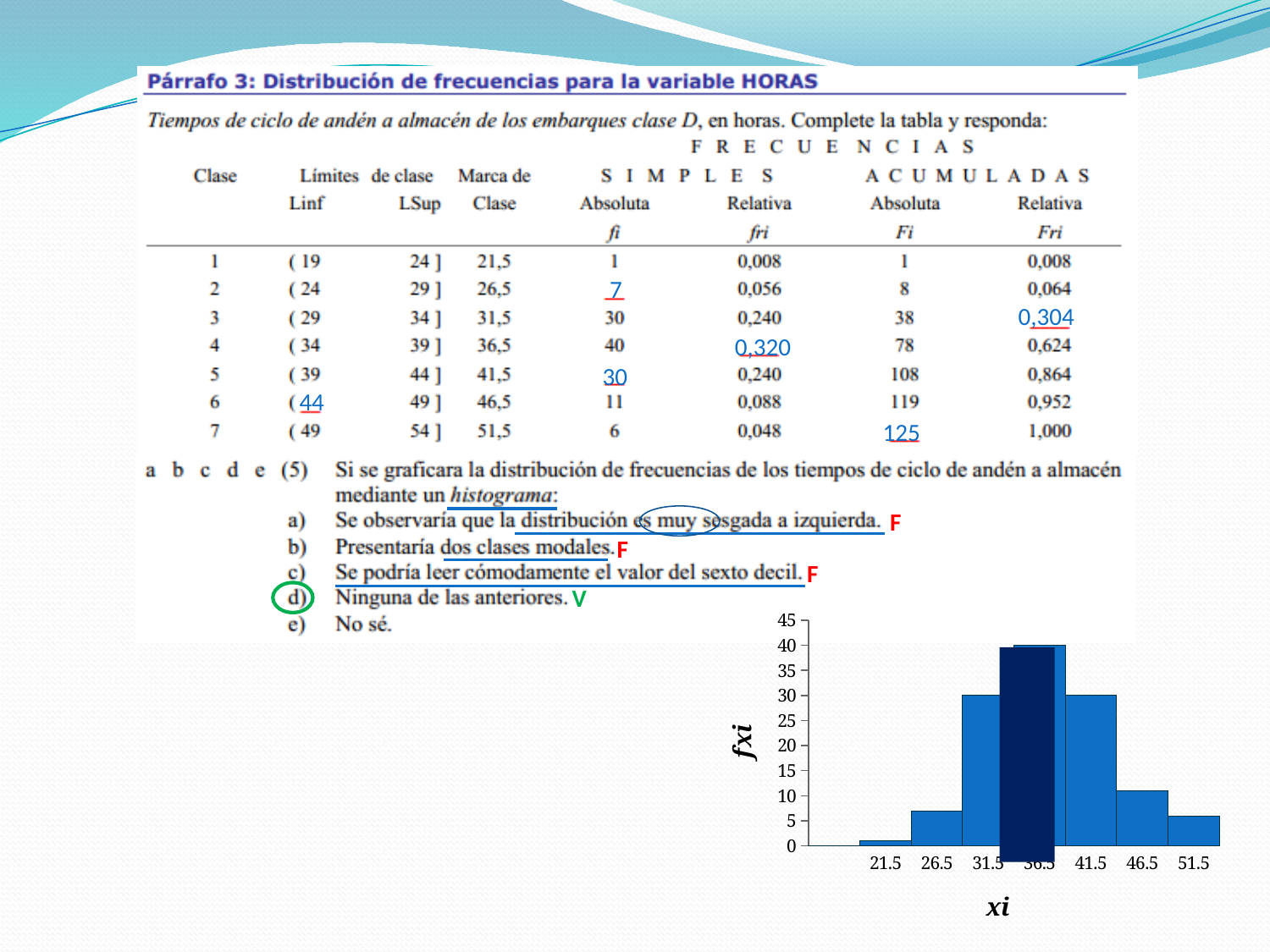
What is the value of the bar at 31.5? 30 What is the value of the bar at 41.5? 30 What is the label of the horizontal axis of the chart? xi How do the bar values change moving from left to right along the x axis? They rise to a peak in the middle and then fall What kind of chart is shown at the bottom right of the slide? bar chart What is the label of the vertical axis of the chart? fxi What is the value of the tallest bar in the chart? 40 How many bars does the chart show? 7 Which bar is taller, the one at 26.5 or the one at 46.5? 46.5 Which x value has the lowest bar in the chart? 21.5 Is the value of the bar at 26.5 greater or less than 10? less